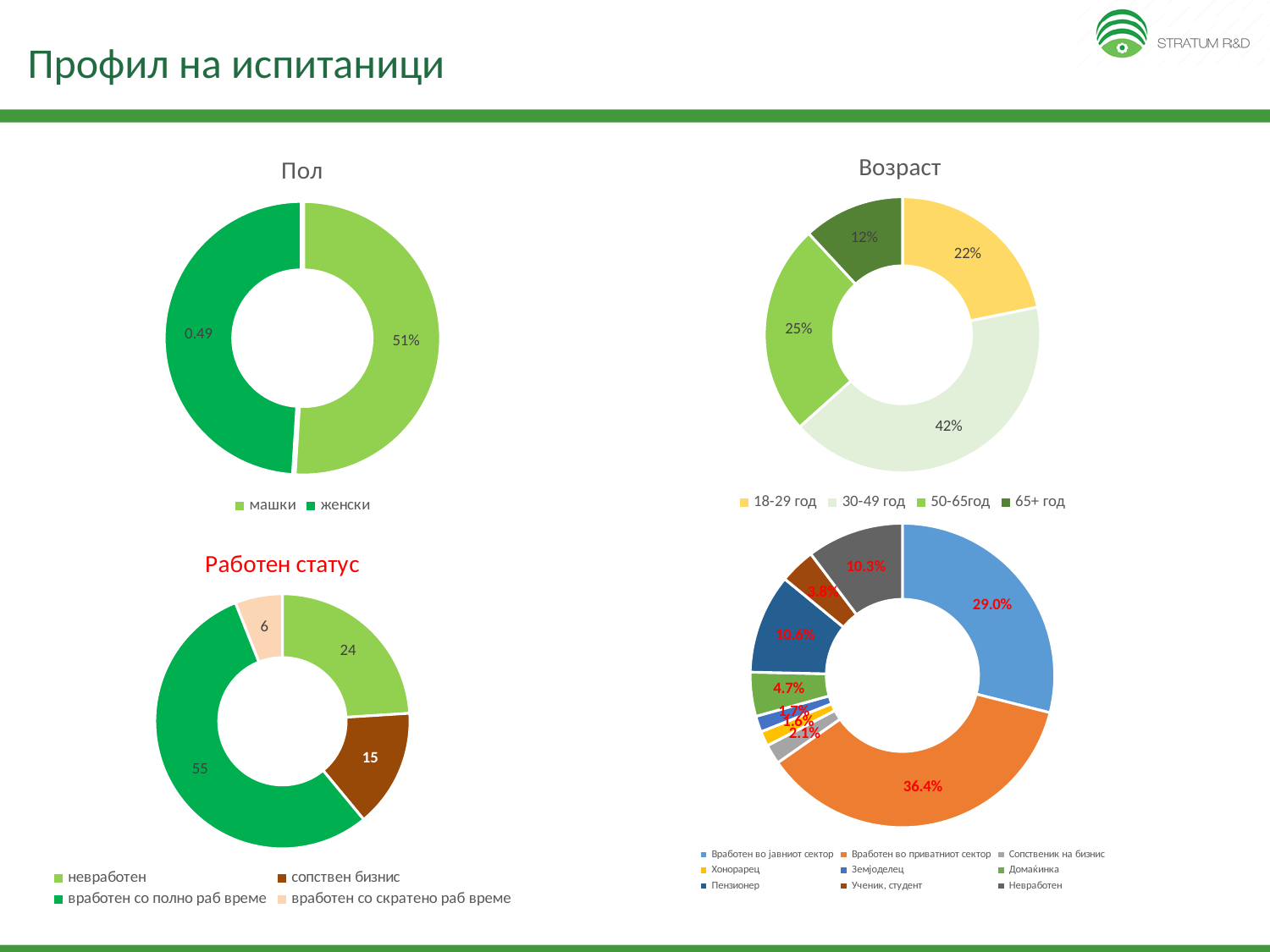
In the "Пол" chart, what value is printed on the женски slice? 0.49 In the bottom-right doughnut chart, what percentage is shown for Вработен во приватниот сектор? 36.4% What kind of chart is the "Возраст" chart? Doughnut (pie) chart In the "Пол" chart, what is the value shown for машки? 51% In the "Работен статус" chart, what is the value for вработен со полно раб време? 55 In the "Работен статус" chart, which category has the lowest value? вработен со скратено раб време In the "Возраст" chart, what share is shown for 30-49 год? 42% In the "Работен статус" chart, which is larger: невработен or сопствен бизнис? невработен In the "Возраст" chart, which age group has the smallest share? 65+ год How many categories does the legend of the "Возраст" chart list? 4 In the bottom-right doughnut chart, what is the difference between Вработен во приватниот сектор and Вработен во јавниот сектор? 7.4% In the "Возраст" chart, what is the difference between the shares for 50-65год and 18-29 год? 3%